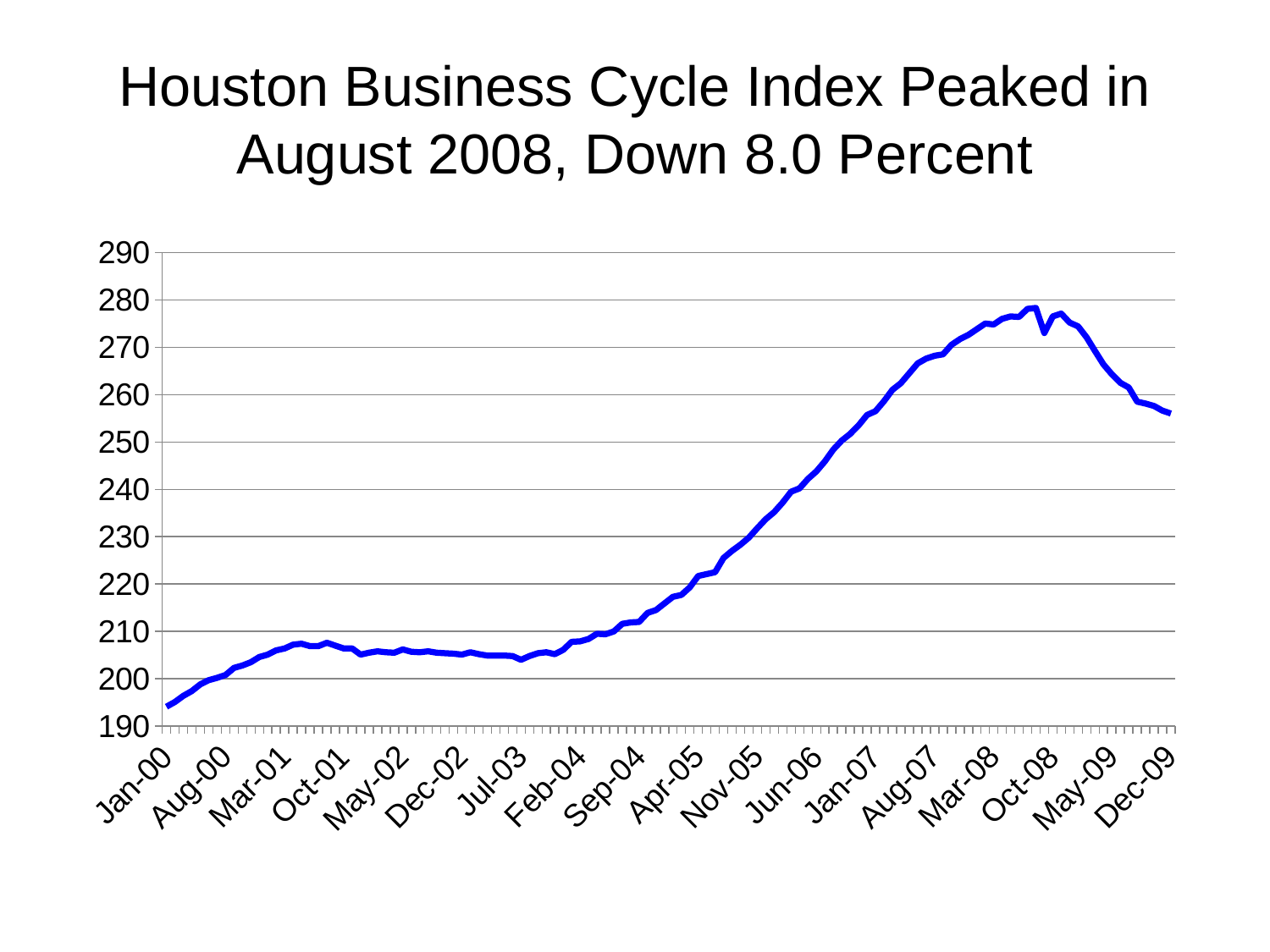
Does the index rise or fall between Oct-08 and Dec-09? fall What kind of chart is shown on the slide? line chart Is the value at Aug-07 greater or less than 260? greater Which is larger, the value at Jan-00 or the value at Dec-09? Dec-09 Is the value at Dec-09 greater or less than 250? greater What is the title of the chart on the slide? Houston Business Cycle Index Peaked in August 2008, Down 8.0 Percent Is the value at Oct-08 greater or less than 270? greater According to the slide title, in which month did the Houston Business Cycle Index peak? August 2008 Does the index rise or fall between Jan-00 and Oct-08? rise